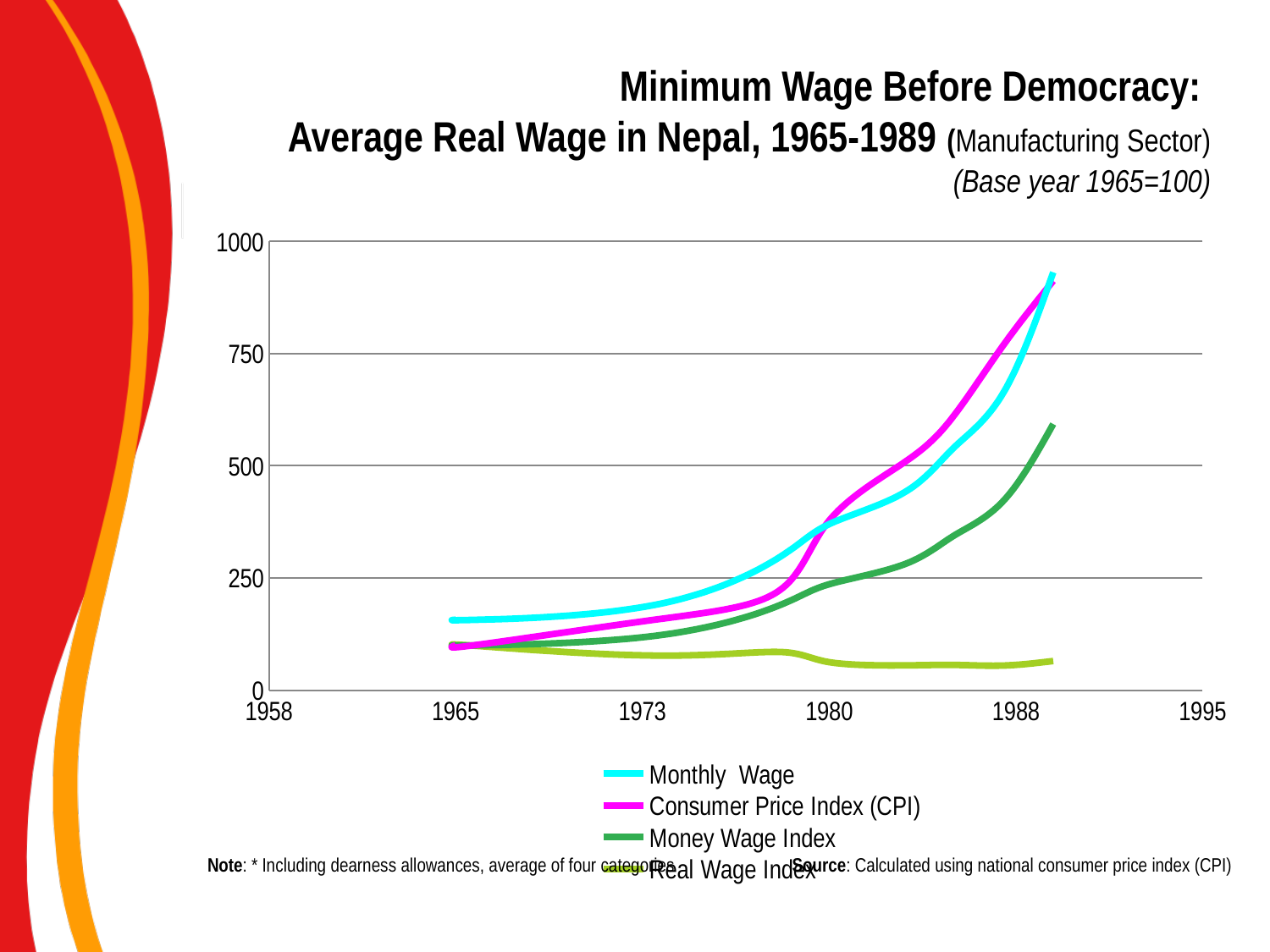
In 1980, which is larger: Consumer Price Index (CPI) or Money Wage Index? Consumer Price Index (CPI) Does the Real Wage Index rise or fall from 1965 to 1989? fall What kind of chart is shown on the slide? line chart Which series has the lowest value in 1988? Real Wage Index Is the Monthly Wage value in 1973 greater or less than 250? less In 1988, which is larger: Monthly Wage or Money Wage Index? Monthly Wage Is the Monthly Wage value in 1980 greater or less than 250? greater Does the Monthly Wage line rise or fall from 1965 to 1989? rise How many series does the legend list? 4 What colour is the Consumer Price Index (CPI) line? magenta Is the Real Wage Index value in 1988 greater or less than 250? less